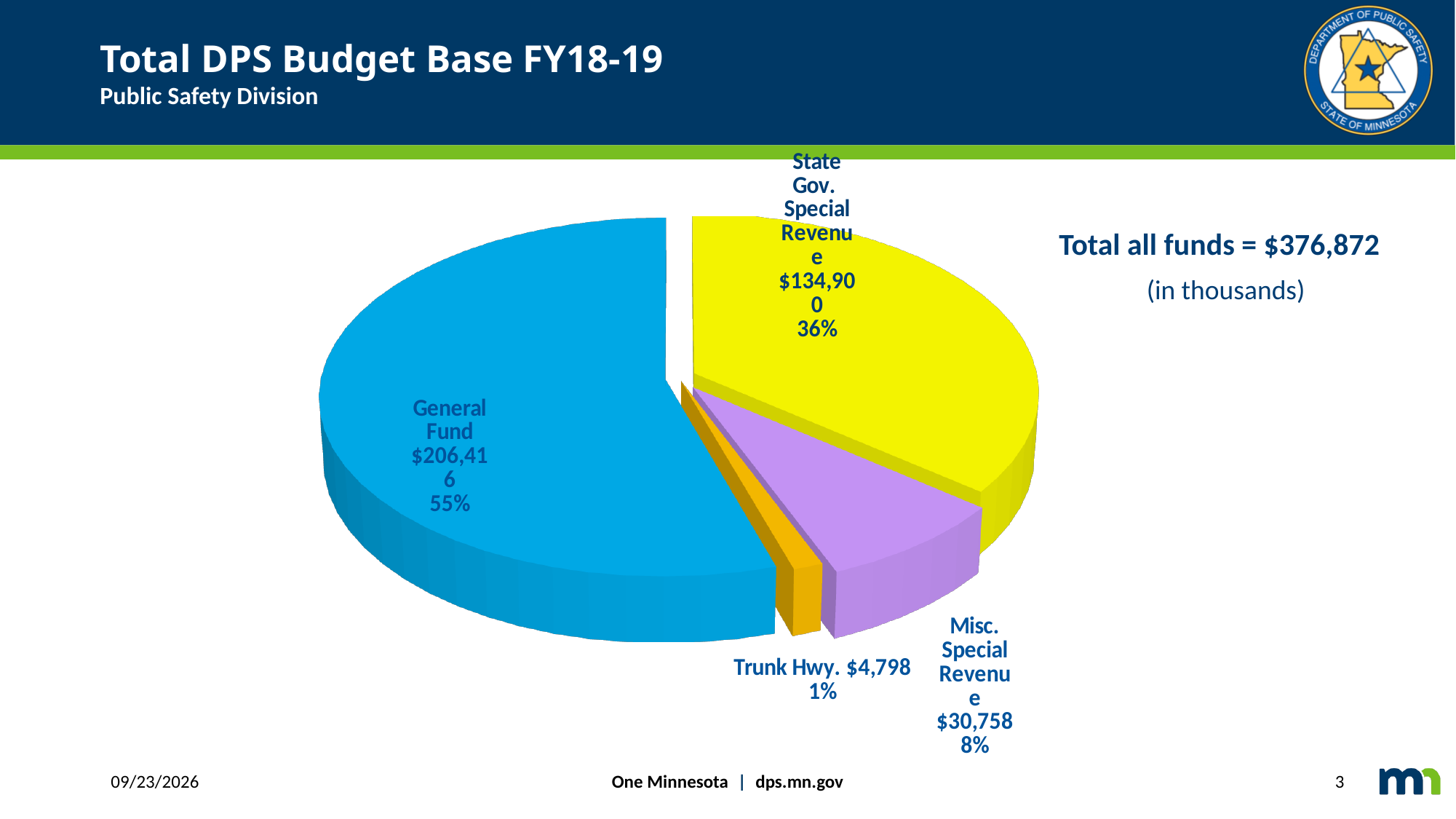
How many slices does the pie chart have? 4 What is the value of the State Gov. Special Revenue slice? $134,900 What is the difference between the General Fund and State Gov. Special Revenue values? $71,516 What is the value of the General Fund slice? $206,416 What is the value of the Misc. Special Revenue slice? $30,758 What is the value of the Trunk Hwy. slice? $4,798 Which slice is the smallest? Trunk Hwy. What share of the pie does Misc. Special Revenue represent? 8% Which slice is the largest? General Fund What share of the pie does the General Fund represent? 55% What kind of chart is shown on the slide? Pie chart What is the total of all funds shown on the slide? $376,872